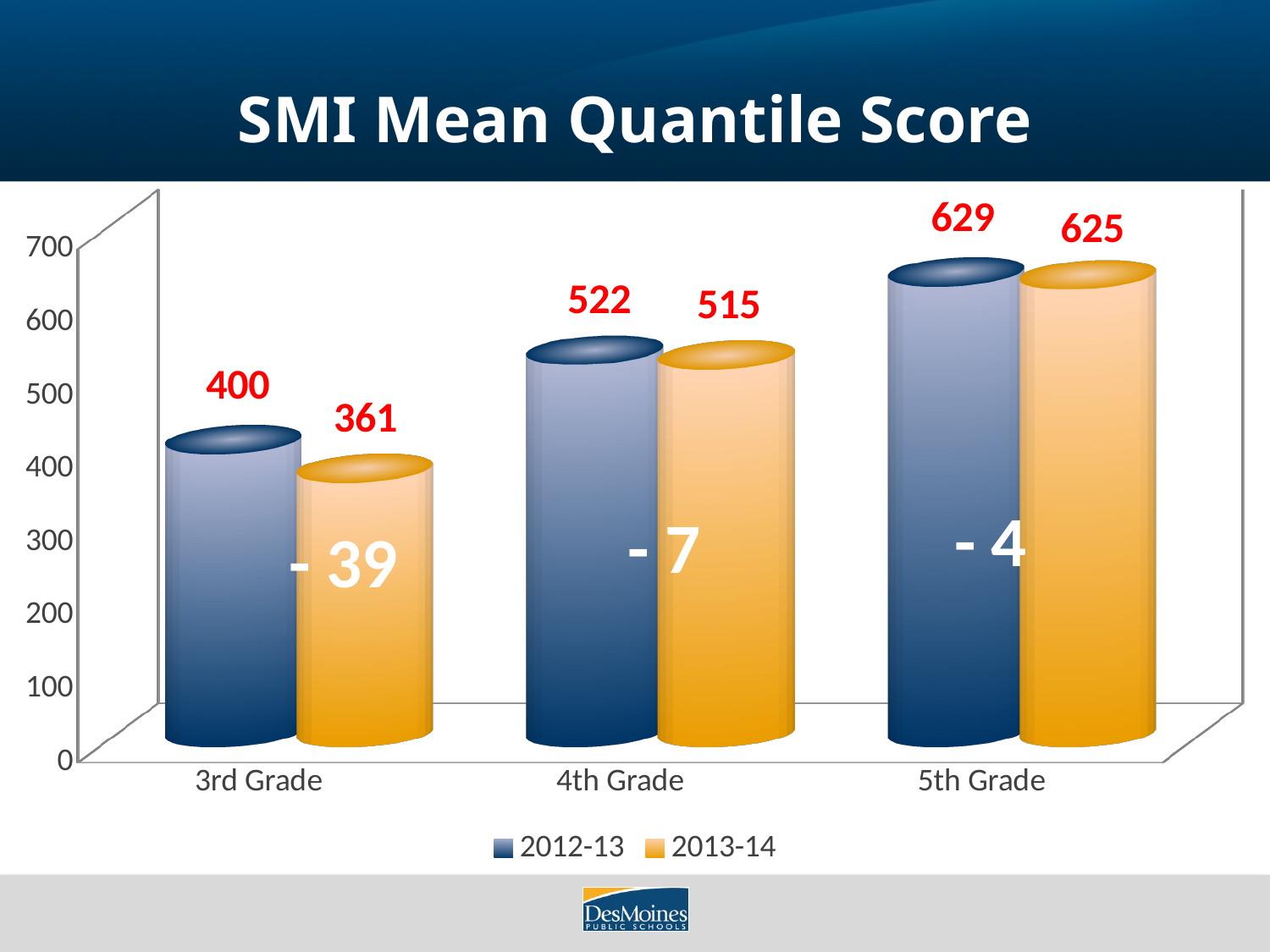
What is the difference between the 2012-13 and 2013-14 scores for 3rd Grade? 39 What kind of chart is shown on the slide? Bar chart What is the difference between the 2012-13 and 2013-14 scores for 4th Grade? 7 What is the 2013-14 SMI mean Quantile score for 4th Grade? 515 Do the 2013-14 scores rise or fall from 3rd Grade to 5th Grade? Rise How many grade levels are shown on the x axis? 3 How many series does the legend list? 2 Which grade has the highest 2012-13 SMI mean Quantile score? 5th Grade For 3rd Grade, which year has the higher score, 2012-13 or 2013-14? 2012-13 What is the 2012-13 SMI mean Quantile score for 3rd Grade? 400 What is the 2013-14 SMI mean Quantile score for 5th Grade? 625 Which grade has the lowest 2013-14 SMI mean Quantile score? 3rd Grade